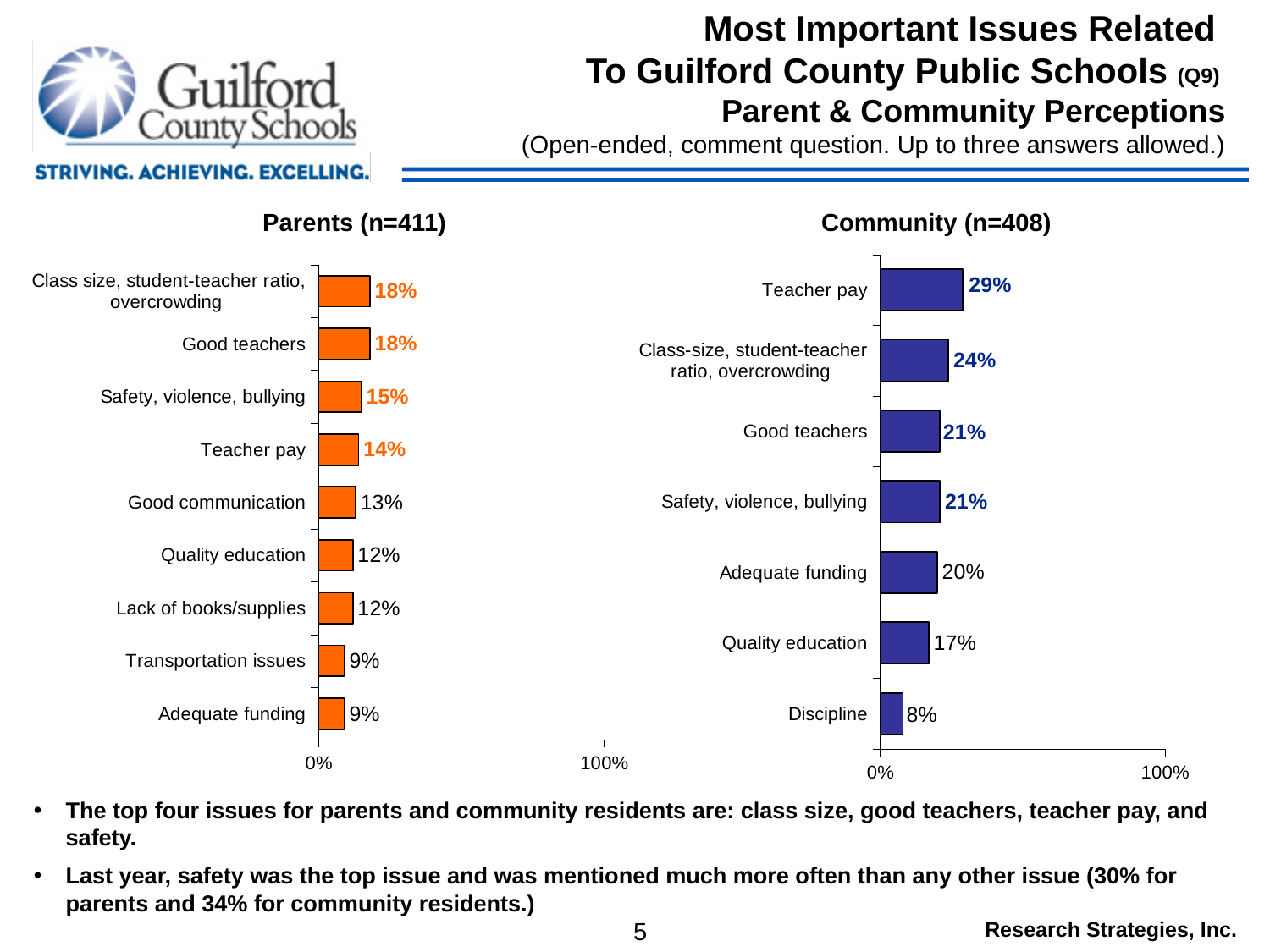
In the Parents (n=411) chart, what is the difference between Good teachers and Teacher pay? 4% What type of chart is the Community (n=408) chart? Bar chart In the Community (n=408) chart, which category has the lowest value? Discipline In the Community (n=408) chart, which category has the highest value? Teacher pay In the Parents (n=411) chart, which is larger: Good communication or Quality education? Good communication How many categories are shown in the Parents (n=411) chart? 9 In the Community (n=408) chart, what is the difference between Teacher pay and Discipline? 21% In the Parents (n=411) chart, what percentage is shown for Transportation issues? 9% In the Community (n=408) chart, what percentage is shown for Teacher pay? 29% How many categories are shown in the Community (n=408) chart? 7 In the Parents (n=411) chart, what percentage is shown for Safety, violence, bullying? 15% In the Community (n=408) chart, which is larger: Adequate funding or Quality education? Adequate funding